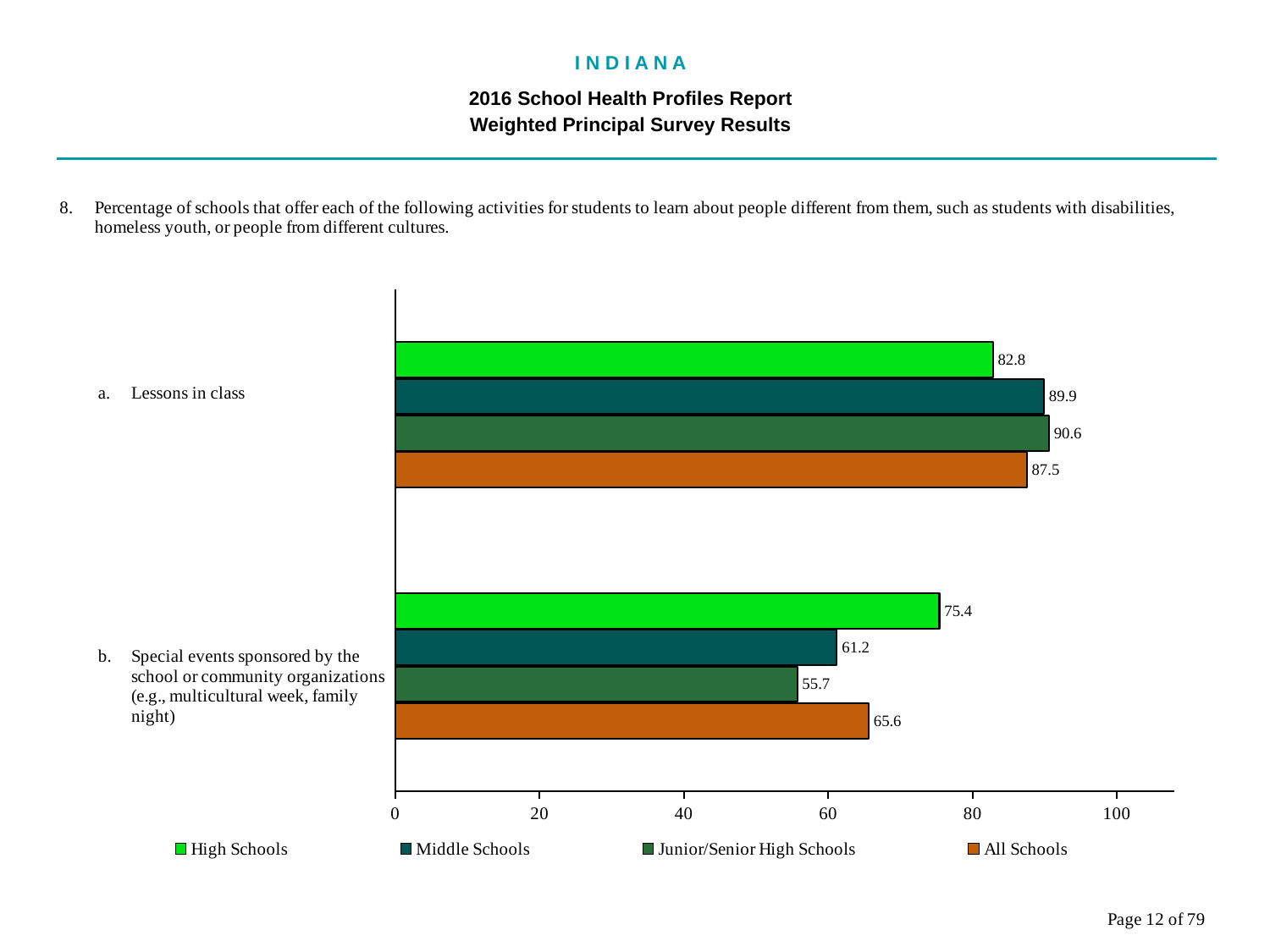
What kind of chart is shown on the slide? bar chart How many series does the legend list? 4 What is the value for All Schools for 'Special events sponsored by the school or community organizations'? 65.6 What is the value for High Schools for 'Lessons in class'? 82.8 Which school type has the lowest value for 'Special events sponsored by the school or community organizations'? Junior/Senior High Schools What is the difference between the High Schools and Middle Schools values for 'Special events sponsored by the school or community organizations'? 14.2 How many activity categories are shown on the chart? 2 Is the value for Middle Schools for 'Special events sponsored by the school or community organizations' greater or less than 60? greater Which is larger for Middle Schools: the value for 'Lessons in class' or for 'Special events sponsored by the school or community organizations'? Lessons in class Which school type has the highest value for 'Lessons in class'? Junior/Senior High Schools What is the value for Junior/Senior High Schools for 'Lessons in class'? 90.6 Which series is shown in orange in the legend? All Schools